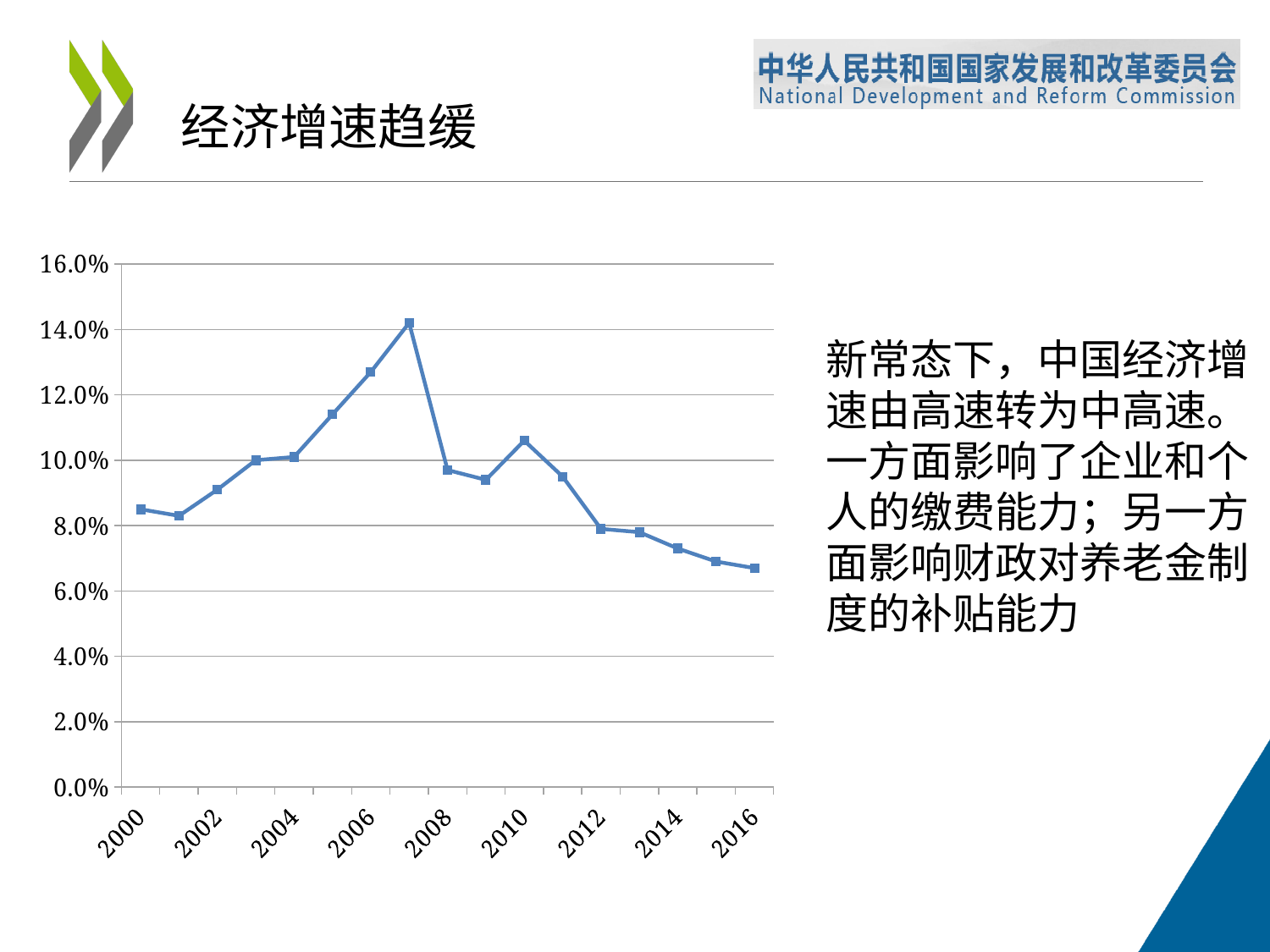
What kind of chart is shown on the slide? line chart Is the value for 2006 greater or less than 12.0%? greater Which is larger, the value for 2006 or the value for 2012? 2006 Do the values rise or fall from 2010 to 2016? fall Which year has the lowest value on the chart? 2016 Is the value for 2016 greater or less than 8.0%? less What is the title of the slide containing the chart? 经济增速趋缓 Is the value for 2000 greater or less than 8.0%? greater How many data points are plotted on the line? 17